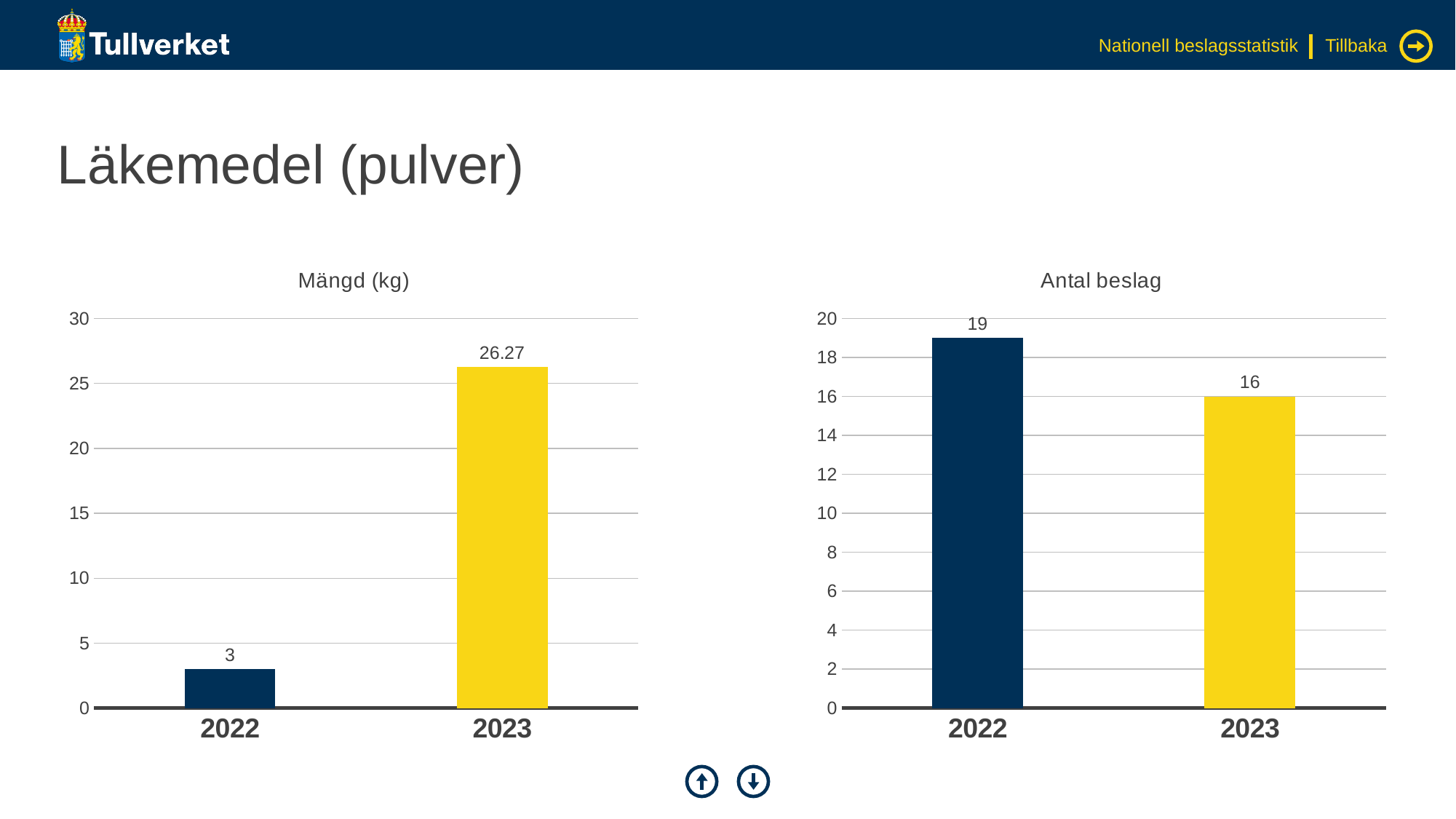
In the 'Antal beslag' chart, what is the difference between the values for 2022 and 2023? 3 What kind of chart is the 'Mängd (kg)' chart? bar chart In the 'Antal beslag' chart, which year has the lowest value? 2023 In the 'Mängd (kg)' chart, what is the value for 2022? 3 In the 'Mängd (kg)' chart, which year has the highest value? 2023 In the 'Mängd (kg)' chart, what is the difference between the values for 2023 and 2022? 23.27 In the 'Mängd (kg)' chart, do the values rise or fall from 2022 to 2023? rise In the 'Mängd (kg)' chart, what is the value for 2023? 26.27 In the 'Antal beslag' chart, what is the value for 2022? 19 In the 'Antal beslag' chart, is the value for 2022 larger or smaller than the value for 2023? larger In the 'Antal beslag' chart, what is the value for 2023? 16 How many categories are shown on the x axis of the 'Antal beslag' chart? 2